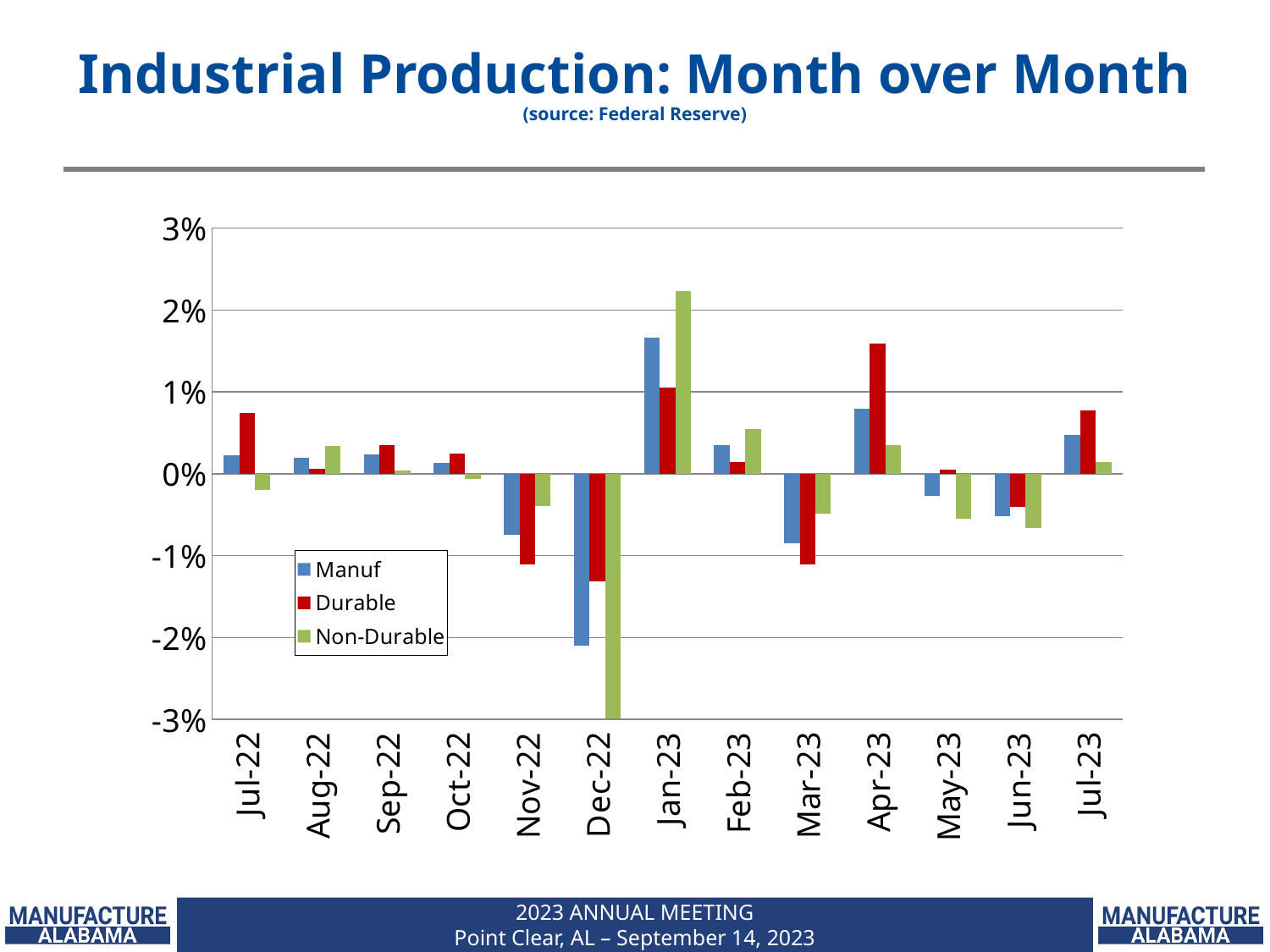
In Jan-23, which is larger: the Non-Durable value or the Manuf value? Non-Durable How many months are shown on the x axis? 13 In which month is the Manuf value lowest? Dec-22 Is the Manuf value for Dec-22 greater or less than -2%? less What colour represents the Durable series in the legend? Red In which month is the Durable value highest? Apr-23 Is the Durable value for Apr-23 greater or less than 1%? greater How many series does the legend list? 3 Is the Non-Durable value for Jan-23 greater or less than 2%? greater What kind of chart is shown on the slide? Bar chart In Apr-23, which is larger: the Durable value or the Manuf value? Durable In which month is the Non-Durable value highest? Jan-23